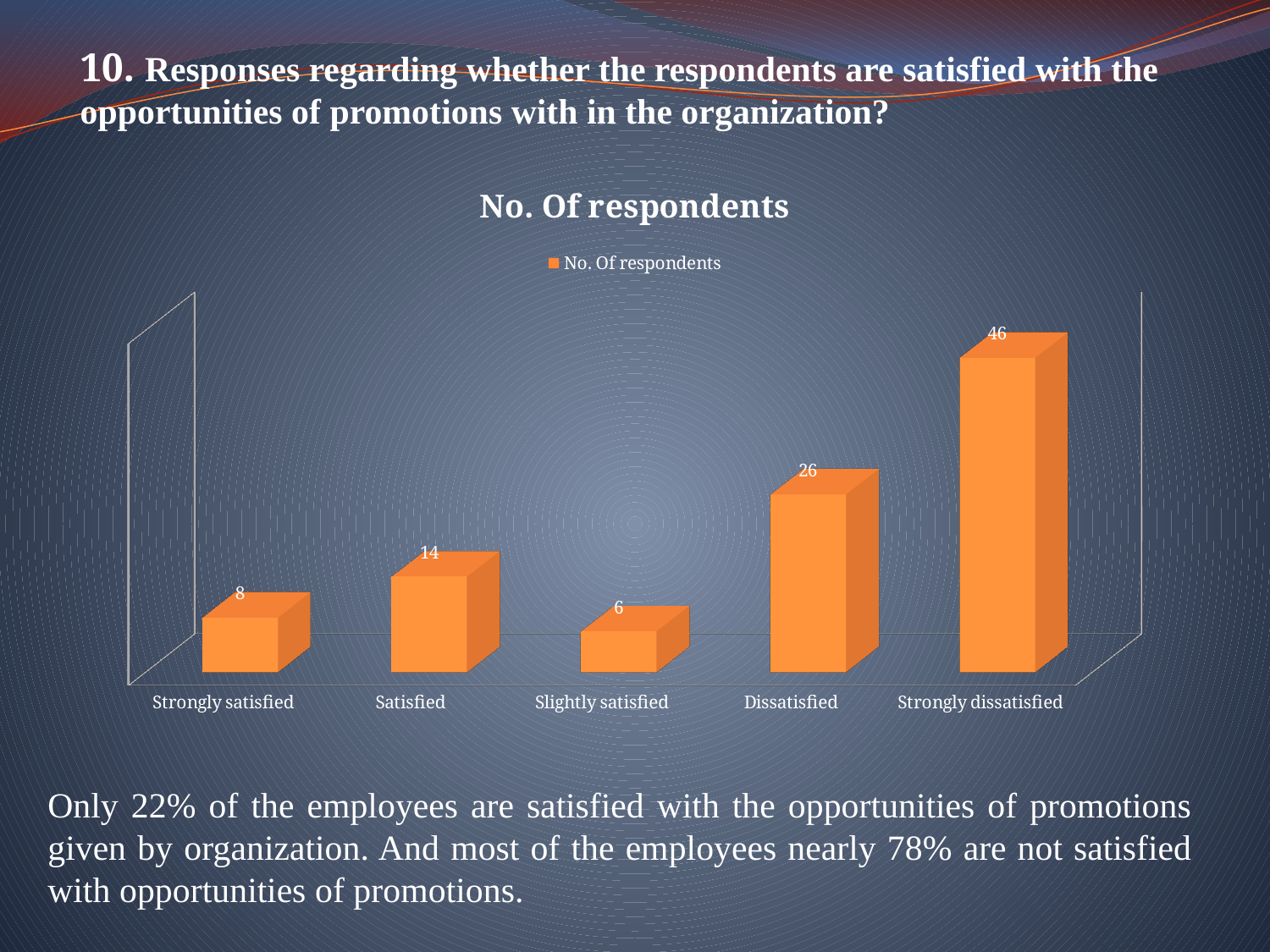
How many series does the legend list? 1 What is the number of respondents for Satisfied? 14 Which has more respondents, Strongly satisfied or Satisfied? Satisfied What is the number of respondents for Slightly satisfied? 6 What kind of chart is shown on the slide? Bar chart What is the number of respondents for Strongly dissatisfied? 46 What is the difference in respondents between Strongly dissatisfied and Dissatisfied? 20 What is the title of the chart? No. Of respondents What is the number of respondents for Dissatisfied? 26 Which category has the highest number of respondents? Strongly dissatisfied Which category has the lowest number of respondents? Slightly satisfied How many categories are shown on the x axis? 5